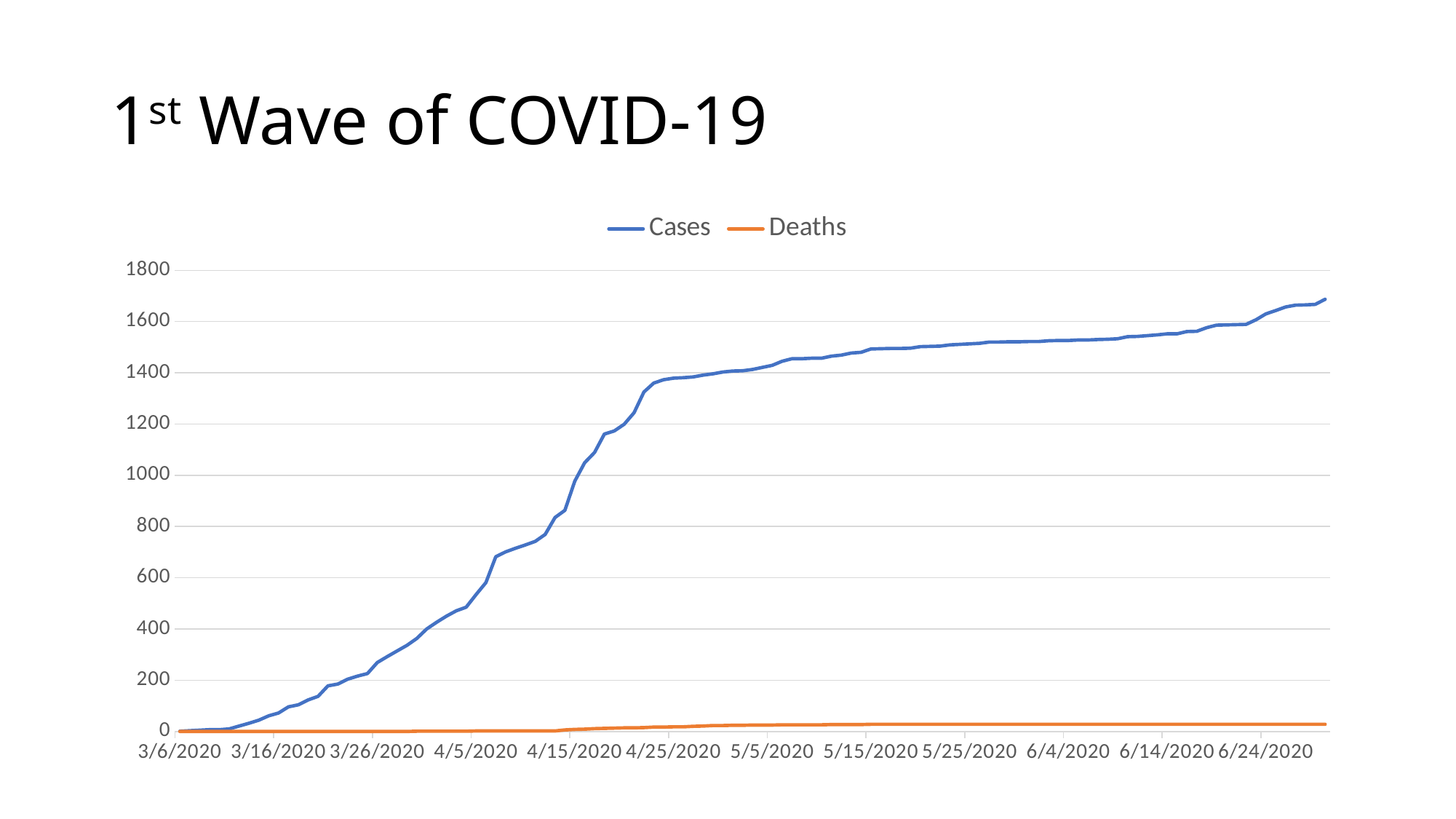
What are the two series named in the legend? Cases and Deaths What kind of chart is shown on the slide? line chart Is the value for Cases at the last date on the chart greater or less than 1800? less Is the value for Cases on 4/5/2020 greater or less than 400? greater How many series does the legend list? 2 Is the value for Cases on 4/15/2020 greater or less than 800? greater Do the Cases values rise or fall from 3/6/2020 to the end of the x axis? rise What is the title of the slide containing the chart? 1st Wave of COVID-19 What is the highest value shown on the vertical axis? 1800 Which series has the higher values throughout the chart, Cases or Deaths? Cases